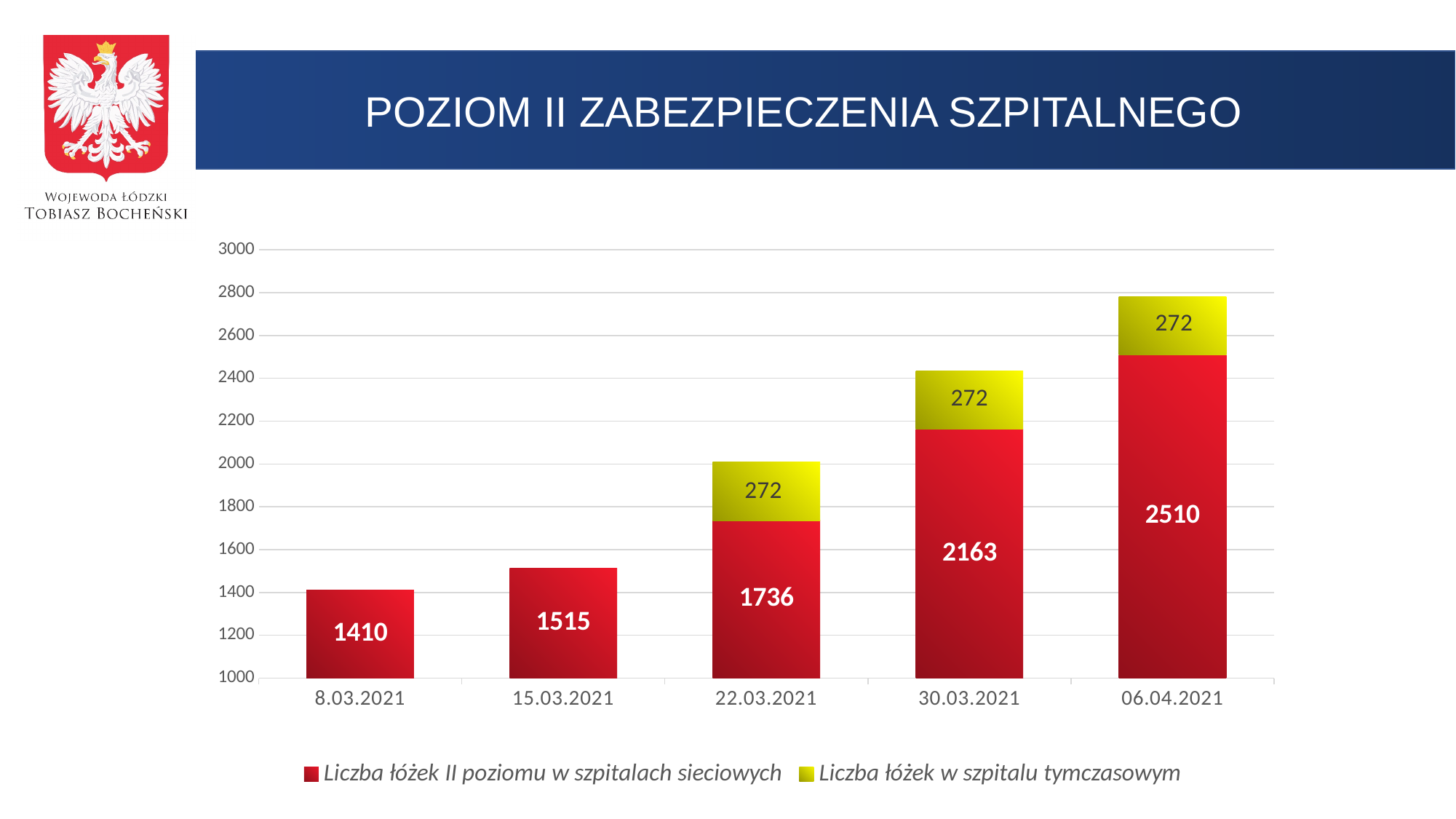
What is the value of 'Liczba łóżek w szpitalu tymczasowym' for 22.03.2021? 272 Which date has the highest value for 'Liczba łóżek II poziomu w szpitalach sieciowych'? 06.04.2021 What is the value of 'Liczba łóżek II poziomu w szpitalach sieciowych' for 8.03.2021? 1410 How many dates are shown on the x axis? 5 What is the total of the stacked bar for 06.04.2021? 2782 What kind of chart is shown on the slide? Stacked bar chart Which is larger: the 'Liczba łóżek II poziomu w szpitalach sieciowych' value for 15.03.2021 or for 22.03.2021? 22.03.2021 How many series does the legend list? 2 Which date has the lowest value for 'Liczba łóżek II poziomu w szpitalach sieciowych'? 8.03.2021 What is the total of the stacked bar for 30.03.2021? 2435 What is the value of 'Liczba łóżek II poziomu w szpitalach sieciowych' for 30.03.2021? 2163 What is the difference between the 'Liczba łóżek II poziomu w szpitalach sieciowych' values for 06.04.2021 and 30.03.2021? 347